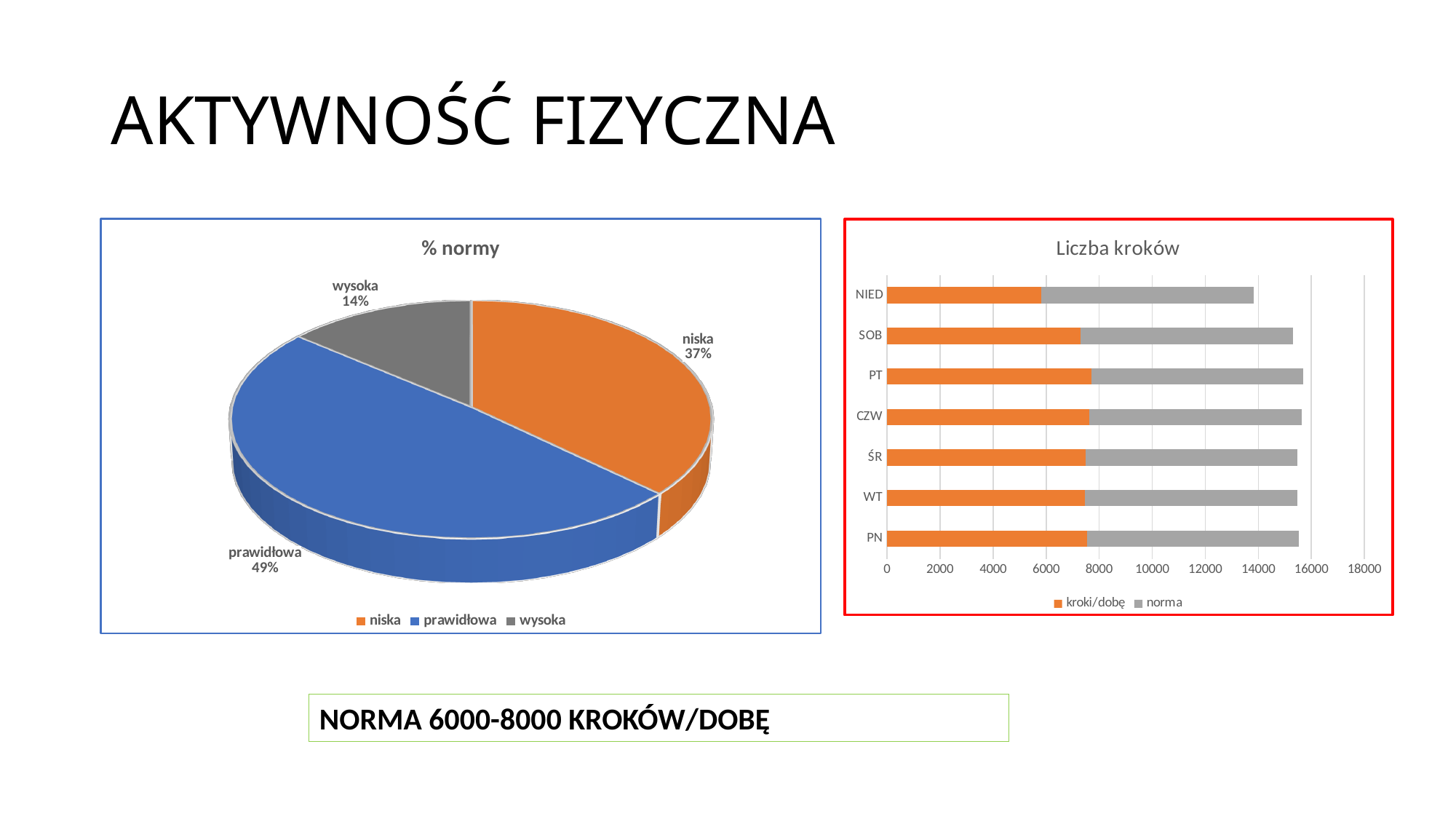
On the pie chart titled "% normy", what is the value for "wysoka"? 14% On the chart titled "Liczba kroków", how many series does the legend list? 2 On the chart titled "Liczba kroków", how many days are shown on the vertical axis? 7 On the chart titled "Liczba kroków", which day has the lowest value for "kroki/dobę"? NIED On the pie chart titled "% normy", what share does the "prawidłowa" slice have? 49% On the pie chart titled "% normy", what is the value for "niska"? 37% On the pie chart titled "% normy", what is the difference between the shares of "prawidłowa" and "niska"? 12% On the pie chart titled "% normy", how many slices are there? 3 What kind of chart is the chart titled "Liczba kroków"? bar chart On the pie chart titled "% normy", which category has the smallest share? wysoka On the pie chart titled "% normy", which category has the largest share? prawidłowa On the chart titled "Liczba kroków", is the value for "kroki/dobę" on SOB greater or less than 6000? greater